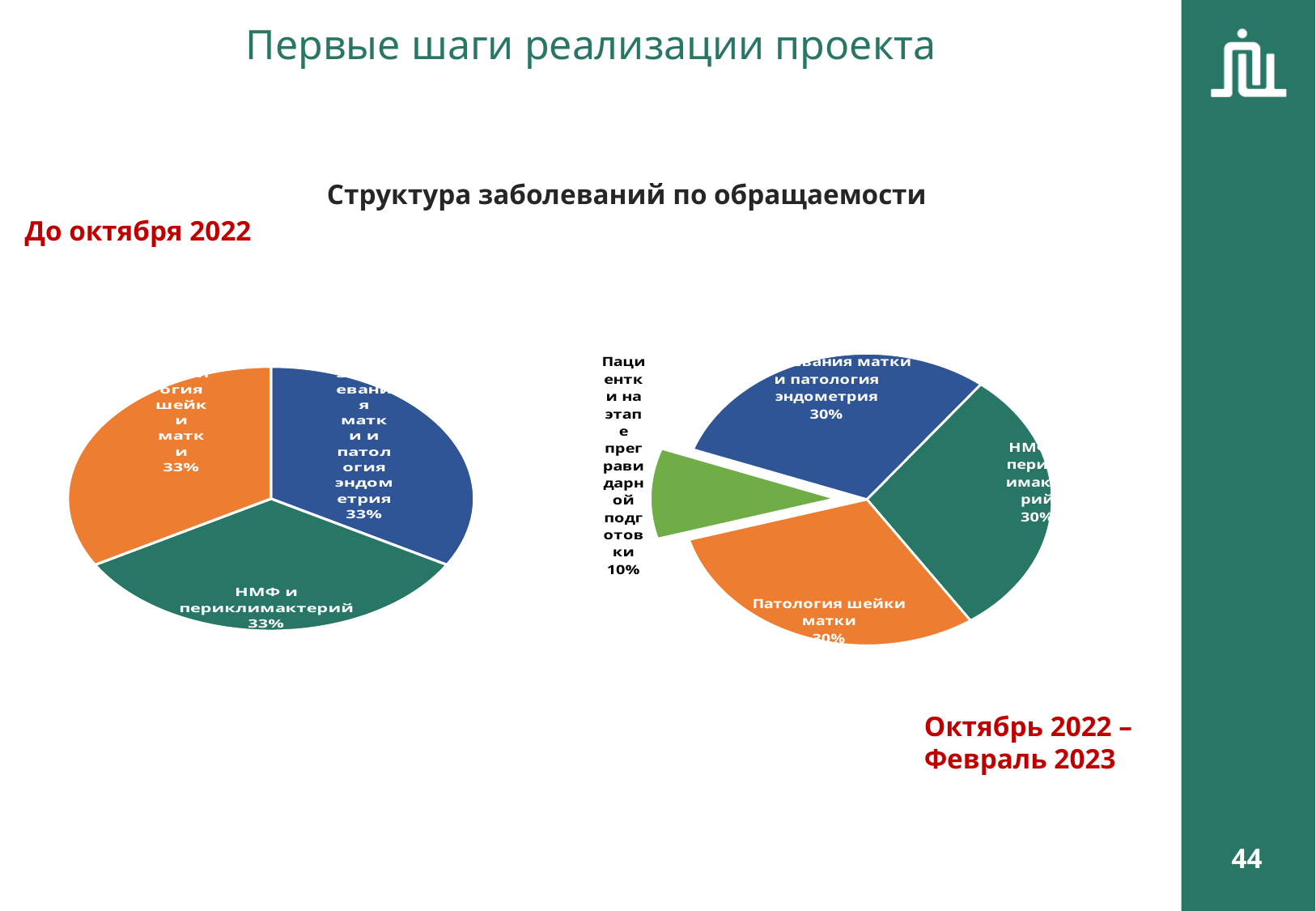
In the left pie chart (До октября 2022), how many slices are there? 3 In the right pie chart (Октябрь 2022 – Февраль 2023), what colour is the slice for 'Пациентки на этапе прегравидарной подготовки'? Green In the right pie chart (Октябрь 2022 – Февраль 2023), which is larger: the share for 'Заболевания матки и патология эндометрия' or the share for 'Пациентки на этапе прегравидарной подготовки'? Заболевания матки и патология эндометрия In the right pie chart (Октябрь 2022 – Февраль 2023), what is the difference between the share for 'НМФ и периклимактерий' and the share for 'Пациентки на этапе прегравидарной подготовки'? 20% In the right pie chart (Октябрь 2022 – Февраль 2023), what share is labelled for 'Пациентки на этапе прегравидарной подготовки'? 10% In the right pie chart (Октябрь 2022 – Февраль 2023), what share is labelled for 'Патология шейки матки'? 30% In the right pie chart (Октябрь 2022 – Февраль 2023), which category has the smallest share? Пациентки на этапе прегравидарной подготовки In the left pie chart (До октября 2022), what share is labelled for 'НМФ и периклимактерий'? 33% What is the common title shown above the two pie charts? Структура заболеваний по обращаемости In the right pie chart (Октябрь 2022 – Февраль 2023), how many slices are there? 4 In the left pie chart (До октября 2022), what share is labelled for 'Патология шейки матки'? 33% What kind of chart is used for the 'До октября 2022' data on the left? Pie chart